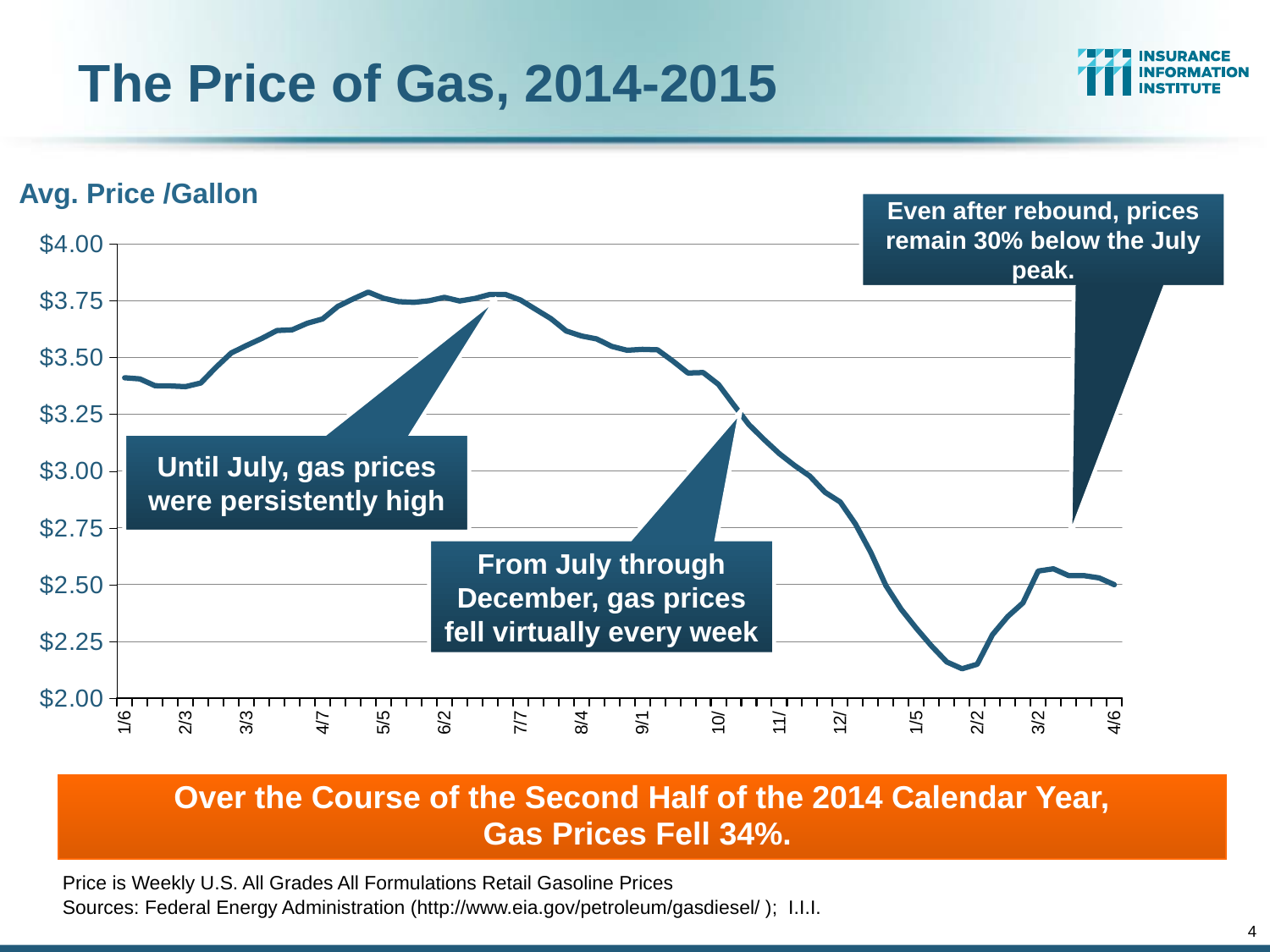
Is the value for 9/1 greater or less than $3.25? greater Is the value for 4/6 greater or less than $2.75? less What label is shown above the y axis of the chart? Avg. Price /Gallon What kind of chart is shown on the slide? line chart Do gas prices rise or fall between 1/6 and 4/7? rise What is the title of the chart on the slide? The Price of Gas, 2014-2015 Which is larger, the value for 5/5 or the value for 2/2? 5/5 Which is larger, the value for 1/6 or the value for 4/6? 1/6 Is the value for 7/7 greater or less than $3.50? greater Do gas prices rise or fall between 7/7 and 1/5? fall